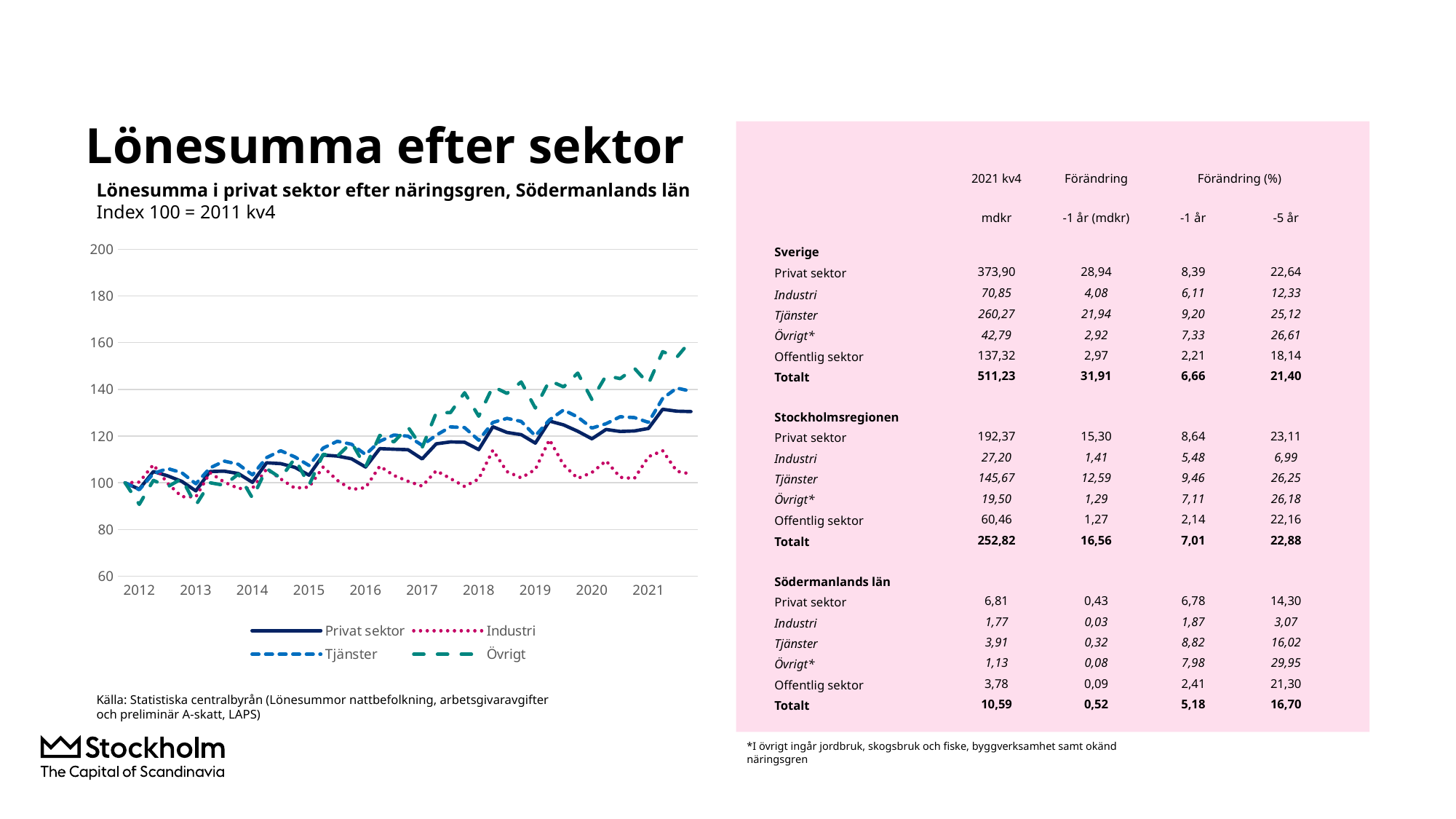
How many series does the chart legend list? 4 Which series has the lowest value at the end of 2021 in the chart? Industri What kind of chart is shown on the slide? line chart Is the value for Industri at the end of 2021 greater or less than 120? less At the end of 2021, which series is higher: Tjänster or Privat sektor? Tjänster What is the title of the chart? Lönesumma i privat sektor efter näringsgren, Södermanlands län How many years are labelled on the x axis of the chart? 10 Which series has the highest value at the end of 2021 in the chart? Övrigt Which series in the chart is drawn as a dotted pink line? Industri Is the lowest value for Övrigt in 2012 greater or less than 100? less Does the Privat sektor series generally rise or fall from 2012 to 2021? rise Is the value for Övrigt at the end of 2021 greater or less than 140? greater